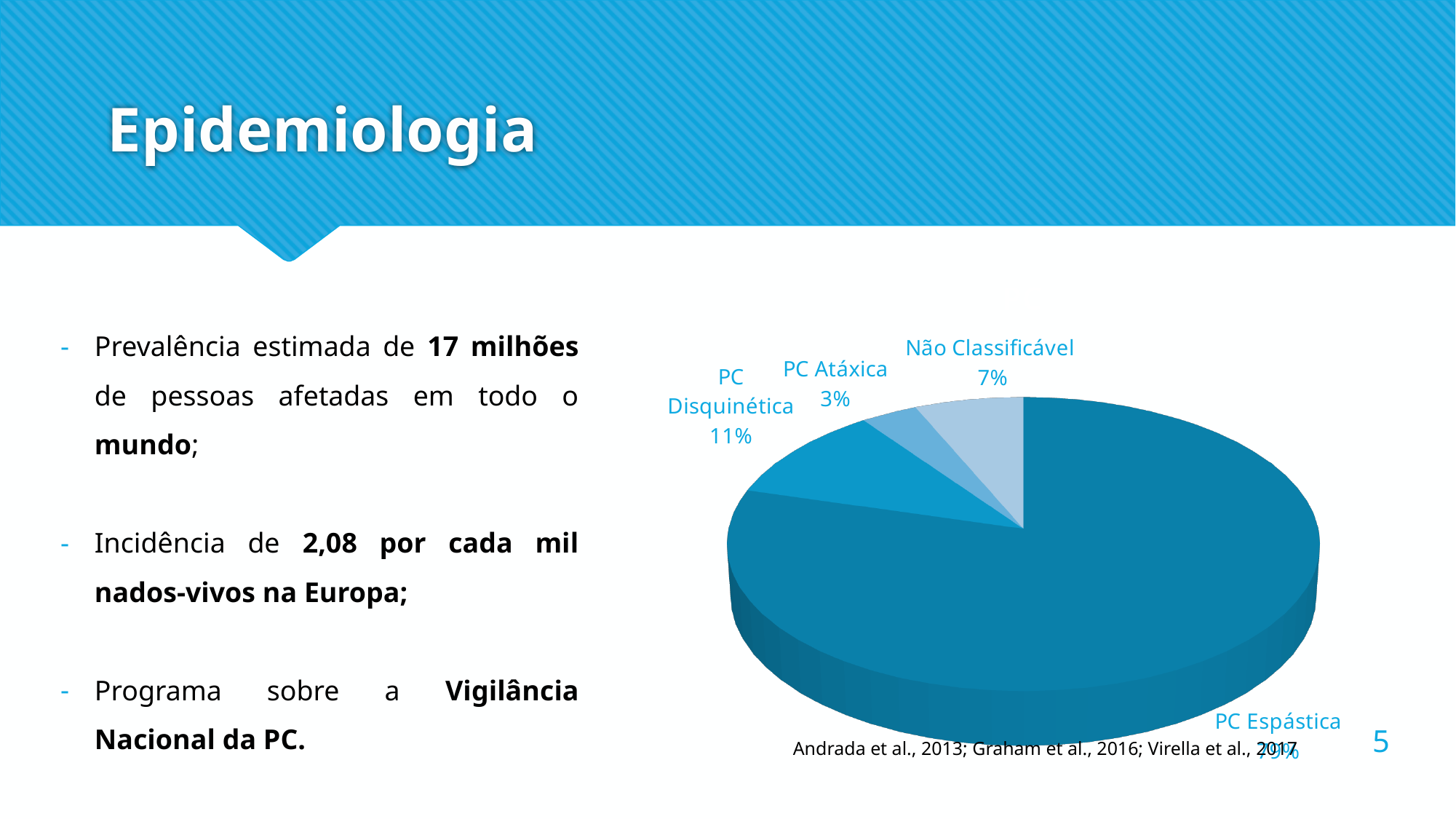
What percentage does the pie chart show for PC Disquinética? 11% Which category has the smallest slice in the pie chart? PC Atáxica Which category has the largest slice in the pie chart? PC Espástica What is the difference in percentage points between PC Disquinética and PC Atáxica in the pie chart? 8% What is the difference in percentage points between Não Classificável and PC Atáxica in the pie chart? 4% Which is larger in the pie chart, PC Atáxica or Não Classificável? Não Classificável How many categories are shown in the pie chart? 4 Which is larger in the pie chart, PC Disquinética or Não Classificável? PC Disquinética What percentage does the pie chart show for PC Atáxica? 3% Which slice of the pie chart is drawn in the lightest shade of blue? Não Classificável What percentage does the pie chart show for Não Classificável? 7% What type of chart is shown on the slide? Pie chart